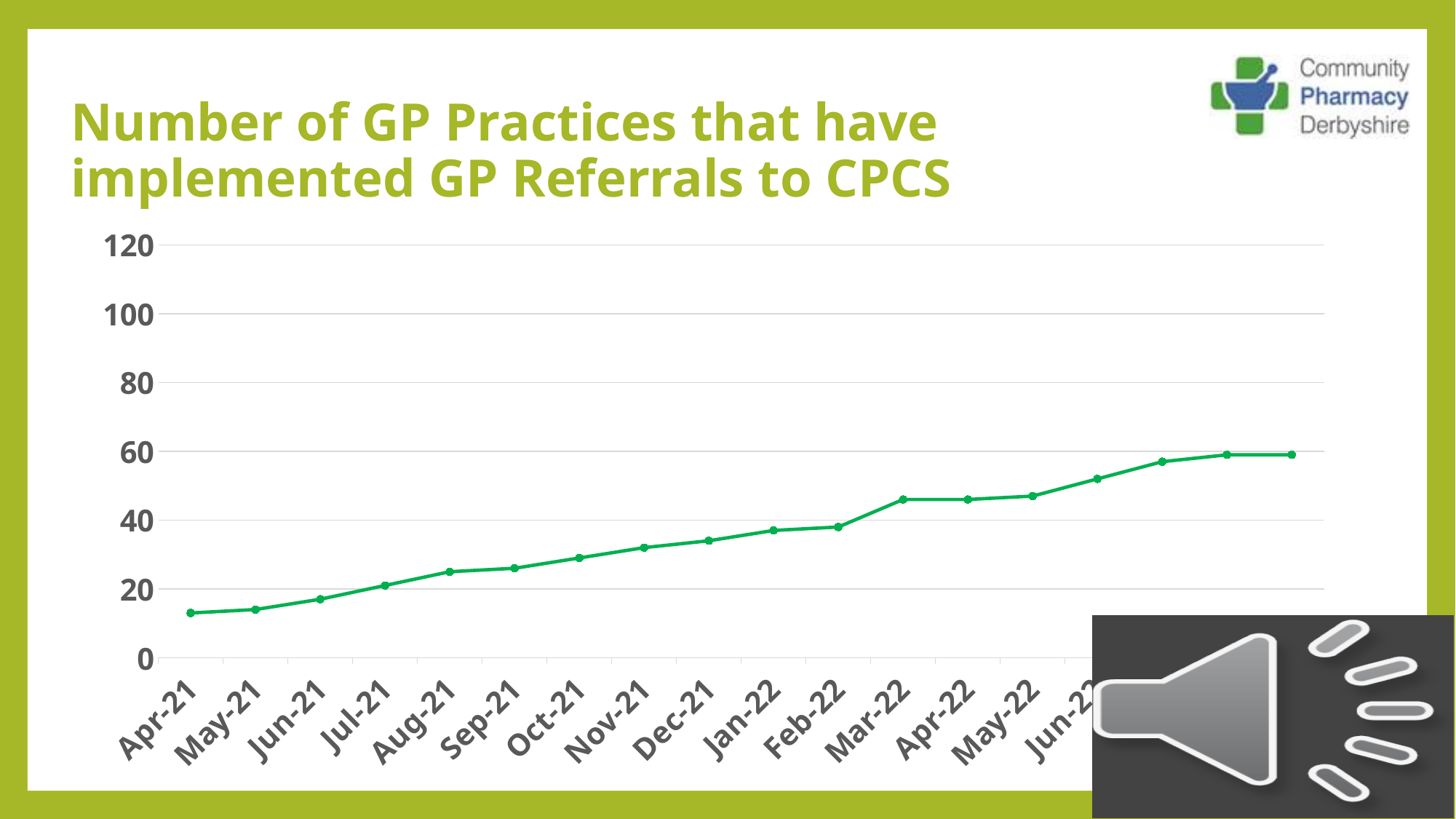
Which month has the lowest value on the chart? Apr-21 Do the values generally rise or fall from Apr-21 to Jun-22? rise What kind of chart is shown on the slide? line chart How many lines are plotted on the chart? 1 Is the value for Dec-21 greater or less than 40? less What is the title of the chart? Number of GP Practices that have implemented GP Referrals to CPCS Which is larger, the value for Sep-21 or the value for Mar-22? Mar-22 Is the value for Apr-21 greater or less than 20? less Which is larger, the value for Jun-21 or the value for Nov-21? Nov-21 Is the value for Aug-21 greater or less than 20? greater